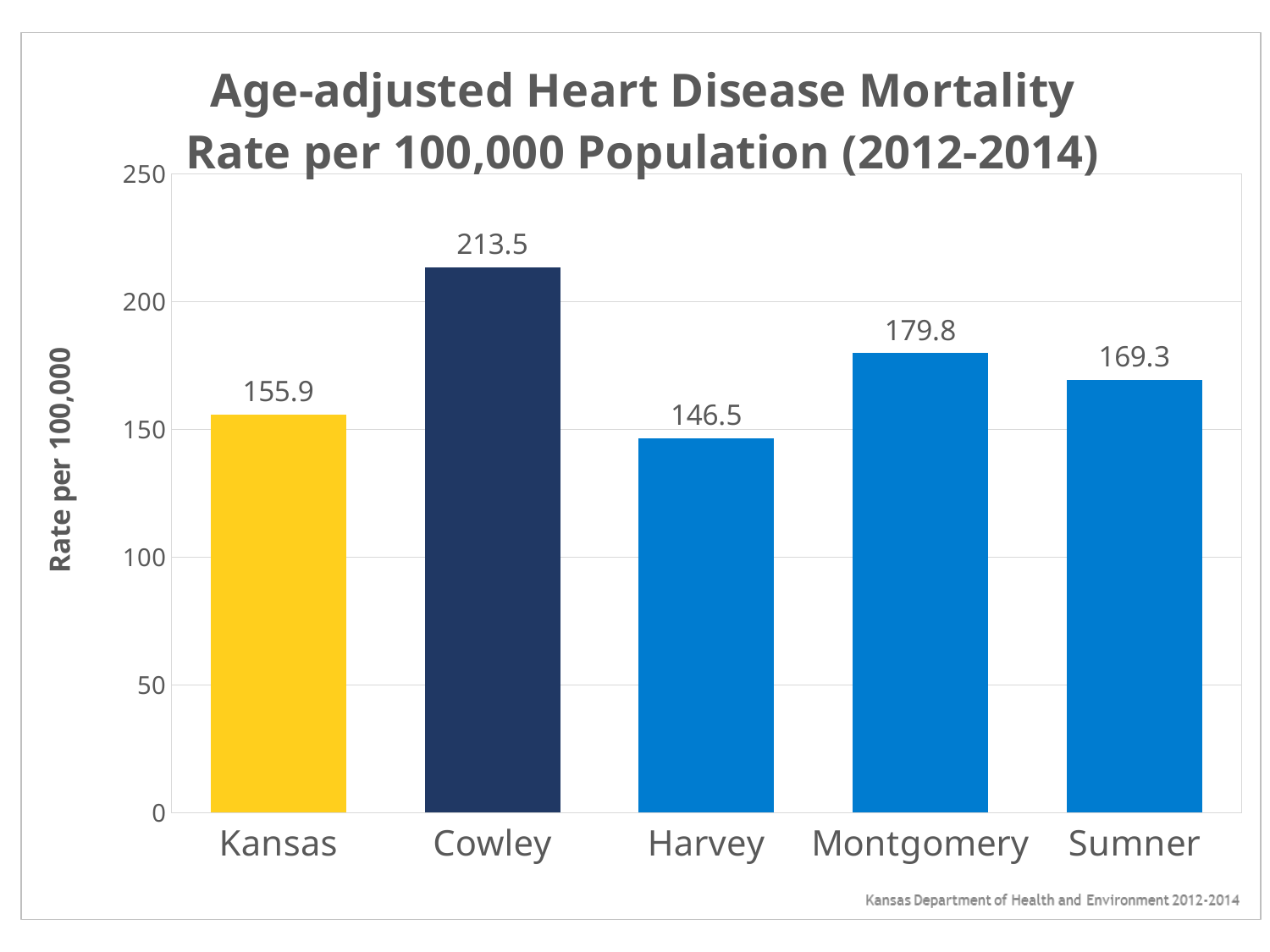
What is the label on the vertical axis of the chart? Rate per 100,000 What is the difference between the mortality rates for Montgomery and Sumner? 10.5 What is the age-adjusted heart disease mortality rate for Sumner? 169.3 How many categories are shown on the chart? 5 What kind of chart is shown on the slide? Bar chart What is the age-adjusted heart disease mortality rate for Kansas? 155.9 Which has a higher mortality rate, Montgomery or Kansas? Montgomery Which category has the highest age-adjusted heart disease mortality rate? Cowley What is the difference between the mortality rates for Cowley and Kansas? 57.6 Which category has the lowest age-adjusted heart disease mortality rate? Harvey What is the age-adjusted heart disease mortality rate for Harvey? 146.5 What is the age-adjusted heart disease mortality rate for Cowley? 213.5